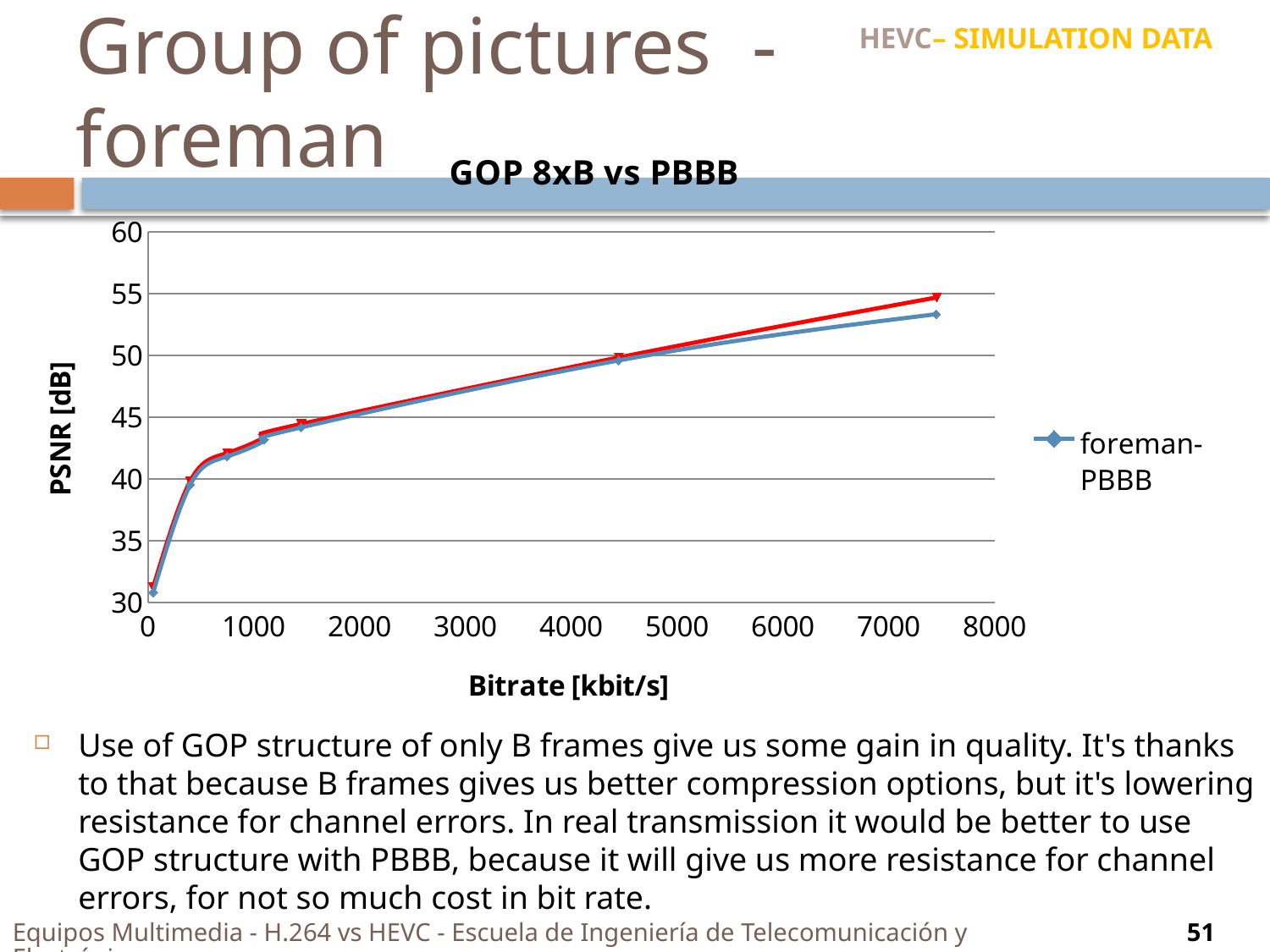
What kind of chart is shown on the slide? line chart Is the PSNR of the red line at its highest bitrate point greater or less than 50? greater How many series does the chart legend list? 1 How many lines are plotted on the chart? 2 How many data points are marked on the foreman-PBBB line? 7 Is the PSNR of foreman-PBBB at its first point (near 0 kbit/s) greater or less than 35? less What is the title of the chart? GOP 8xB vs PBBB At the highest bitrate plotted, which line has the higher PSNR, the red line or the blue foreman-PBBB line? the red line Is the PSNR of foreman-PBBB at around 1100 kbit/s greater or less than 45? less Does PSNR rise or fall as bitrate increases along the x axis? rise What is the label of the y axis of the chart? PSNR [dB]